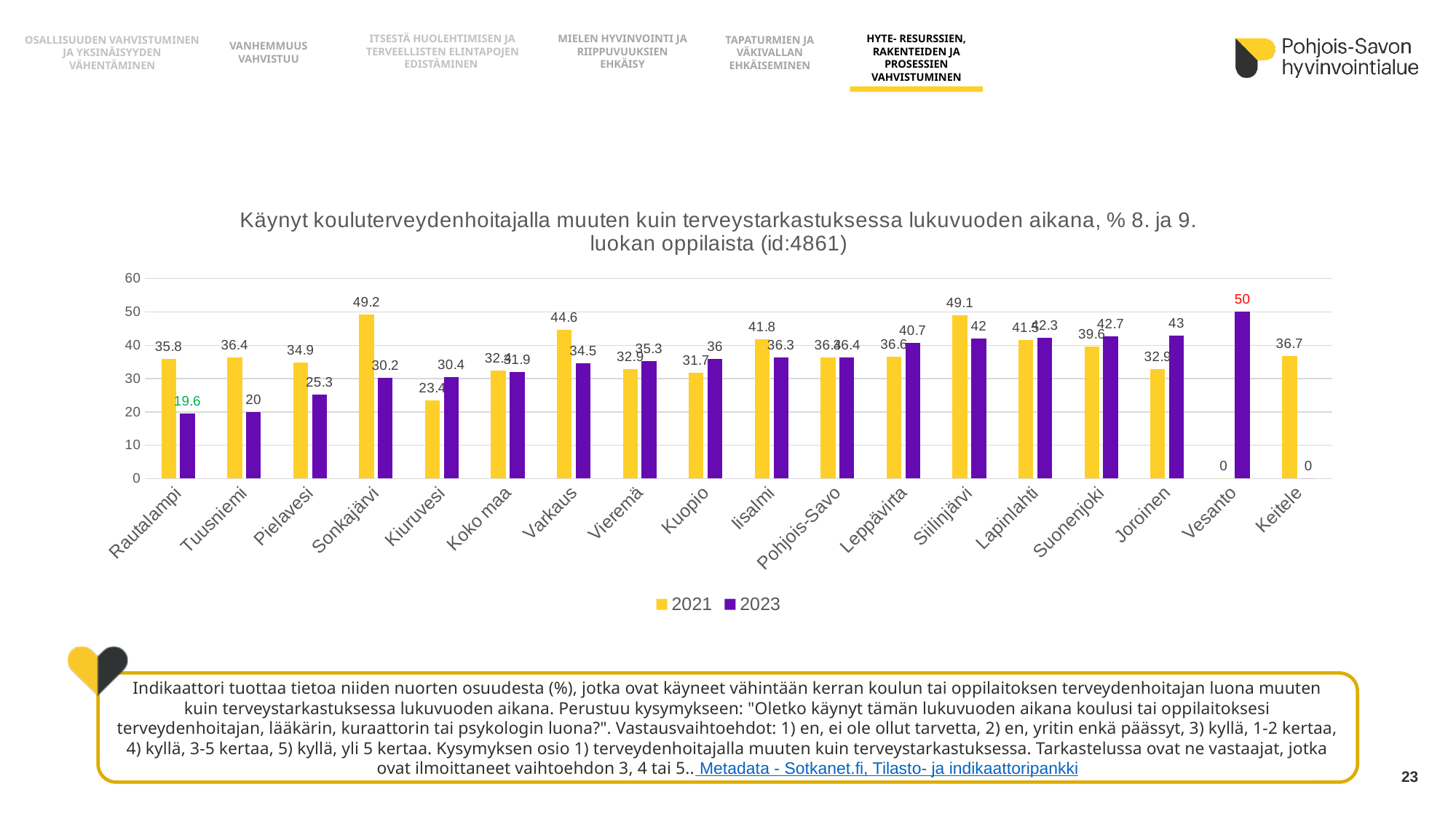
What is the 2023 value for Rautalampi? 19.6 What is the 2023 value for Vesanto? 50 Which category has the highest 2023 value? Vesanto Is the 2023 value for Joroinen greater or less than 40? greater What kind of chart is shown on the slide? bar chart Which category has the lowest 2023 value? Keitele For Kiuruvesi, which year has the larger value, 2021 or 2023? 2023 How many series does the legend list? 2 What is the difference between the 2021 and 2023 values for Sonkajärvi? 19 What is the difference between the 2021 and 2023 values for Varkaus? 10.1 What is the 2021 value for Sonkajärvi? 49.2 How many categories are shown on the x axis? 18